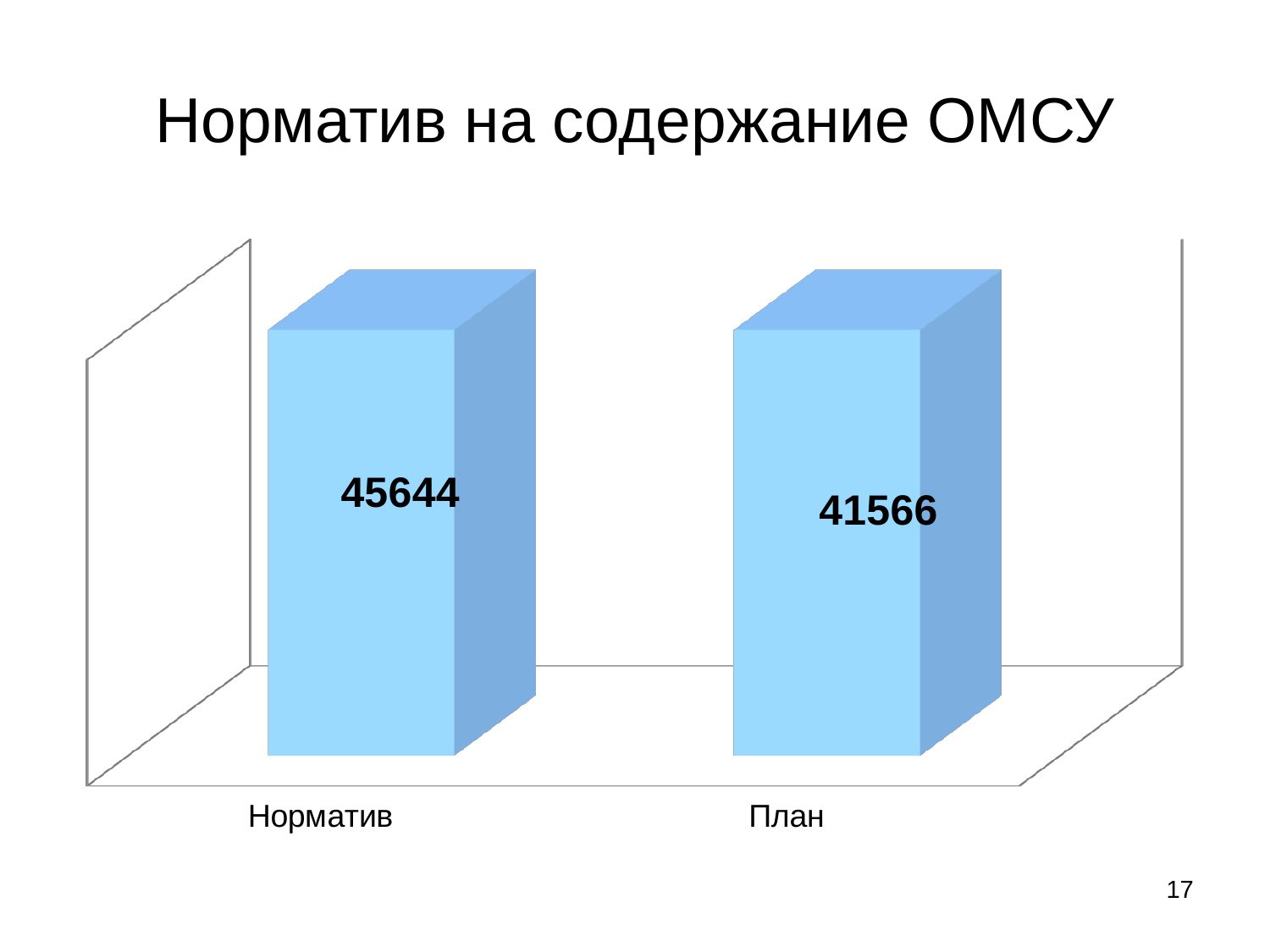
What is the difference between the values for Норматив and План? 4078 Which category has the lowest value? План What is the title of the slide? Норматив на содержание ОМСУ What is the value for Норматив? 45644 What is the value for План? 41566 Which is larger, the value for Норматив or the value for План? Норматив Do the values rise or fall from Норматив to План? fall What kind of chart is shown on the slide? bar chart Which category has the highest value? Норматив What colour are the bars in the chart? light blue How many categories are shown in the chart? 2